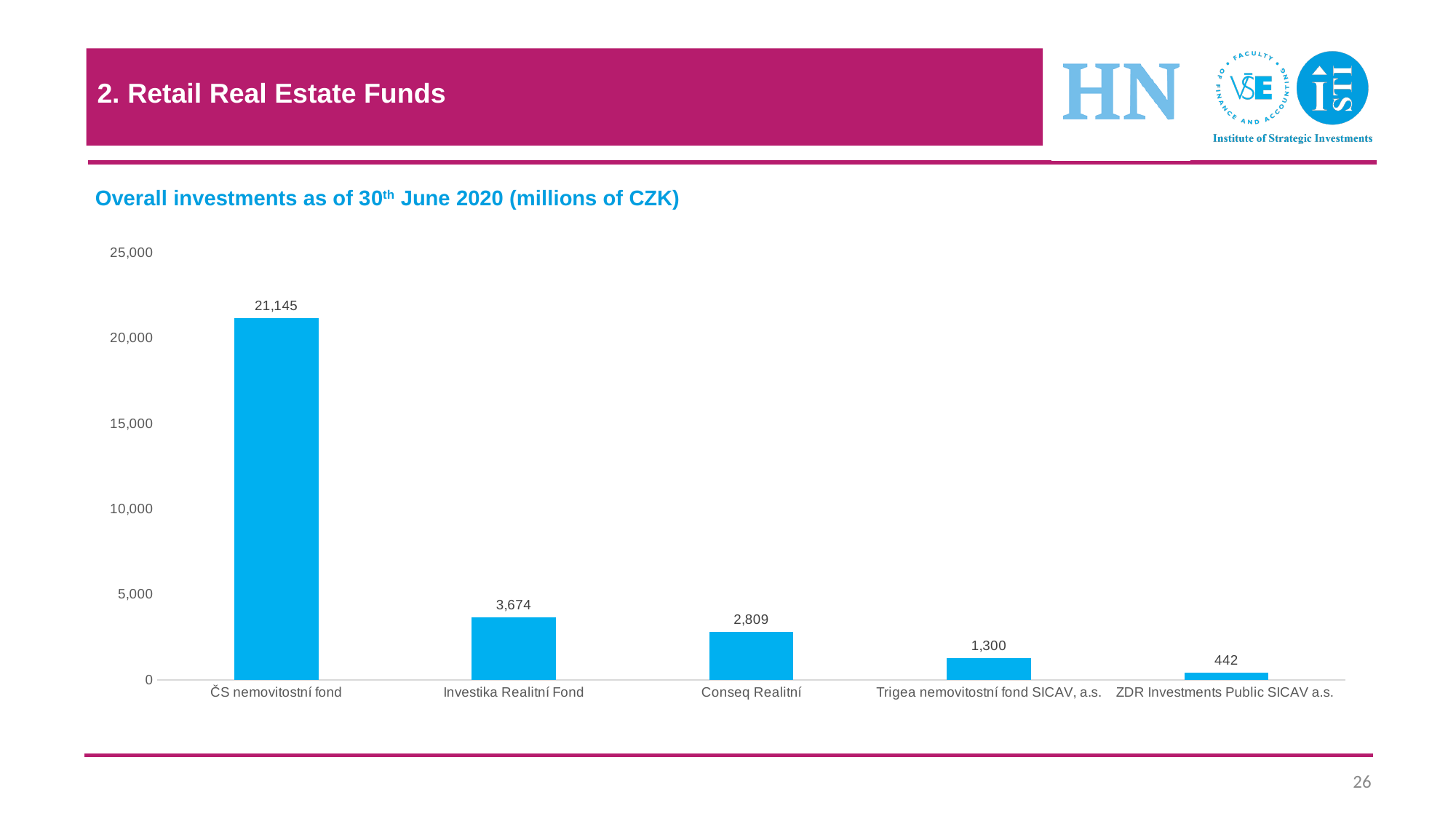
What is the value for Trigea nemovitostní fond SICAV, a.s.? 1,300 Which is larger, the value for Trigea nemovitostní fond SICAV, a.s. or the value for ZDR Investments Public SICAV a.s.? Trigea nemovitostní fond SICAV, a.s. Which fund has the lowest overall investments? ZDR Investments Public SICAV a.s. What is the value for ČS nemovitostní fond? 21,145 What kind of chart is shown on the slide? Bar chart What is the value for Investika Realitní Fond? 3,674 What is the value for Conseq Realitní? 2,809 How many funds are shown in the chart? 5 What is the difference between the values for Investika Realitní Fond and Conseq Realitní? 865 What is the title of the chart? Overall investments as of 30th June 2020 (millions of CZK) What is the value for ZDR Investments Public SICAV a.s.? 442 Which fund has the highest overall investments? ČS nemovitostní fond